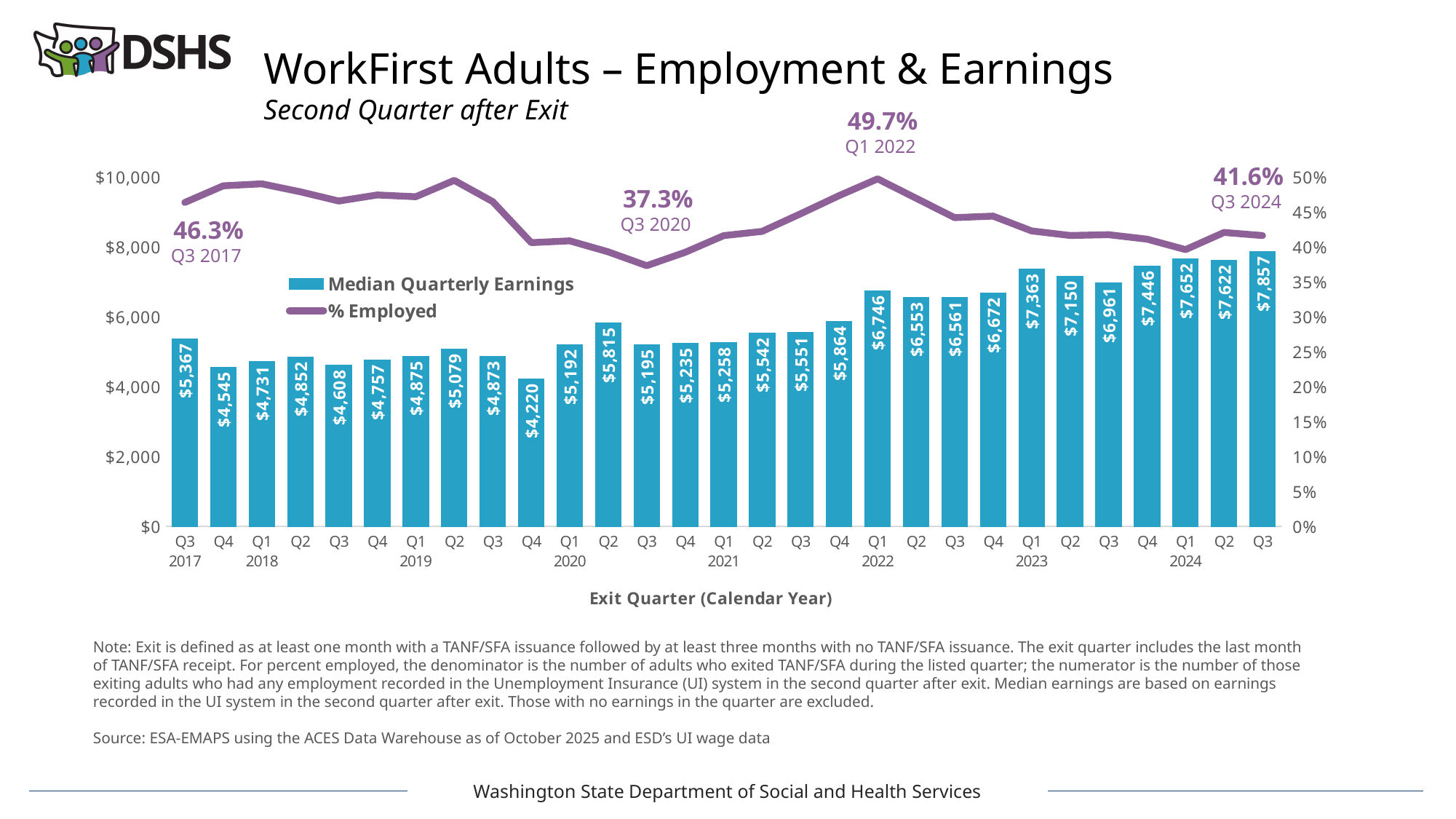
Do median quarterly earnings generally rise or fall from Q1 2020 to Q3 2024? Rise How many series does the legend list? 2 What is the median quarterly earnings value for Q1 2022? $6,746 What kind of chart is this? Combination bar and line chart What is the median quarterly earnings value for Q4 2019? $4,220 Which exit quarter has the highest median quarterly earnings? Q3 2024 Is the % Employed value for Q4 2019 greater or less than 45%? less What is the difference in median quarterly earnings between Q3 2024 and Q3 2017? $2,490 Which has higher median quarterly earnings, Q1 2023 or Q2 2023? Q1 2023 What percent employed is labelled for Q3 2020? 37.3% Which exit quarter has the lowest median quarterly earnings? Q4 2019 How many exit quarters are shown on the x axis? 29